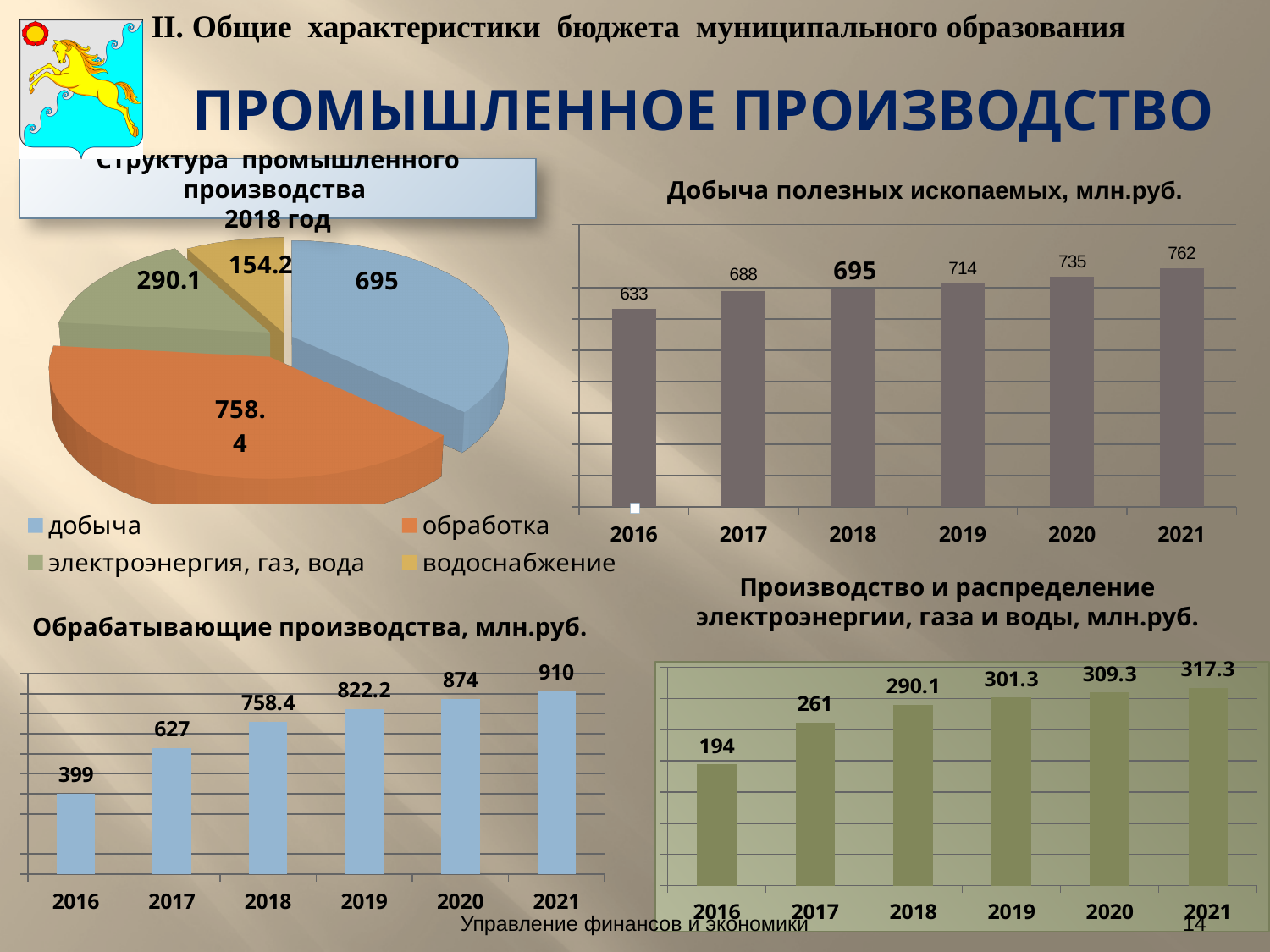
What kind of chart is 'Добыча полезных ископаемых, млн.руб.'? bar chart In the chart 'Добыча полезных ископаемых, млн.руб.', which year has the highest value? 2021 In the chart 'Добыча полезных ископаемых, млн.руб.', what is the value for 2016? 633 In the chart 'Обрабатывающие производства, млн.руб.', which year has the lowest value? 2016 In the pie chart 'Структура промышленного производства 2018 год', what is the value for 'обработка'? 758.4 In the chart 'Обрабатывающие производства, млн.руб.', do the values rise or fall from 2016 to 2021? rise In the chart 'Производство и распределение электроэнергии, газа и воды, млн.руб.', what is the difference between the 2018 and 2016 values? 96.1 In the chart 'Производство и распределение электроэнергии, газа и воды, млн.руб.', what is the value for 2017? 261 In the pie chart 'Структура промышленного производства 2018 год', which category has the smallest slice? водоснабжение In the chart 'Добыча полезных ископаемых, млн.руб.', what is the difference between the 2021 and 2016 values? 129 How many categories does the legend of the pie chart 'Структура промышленного производства 2018 год' list? 4 In the chart 'Обрабатывающие производства, млн.руб.', what is the value for 2019? 822.2